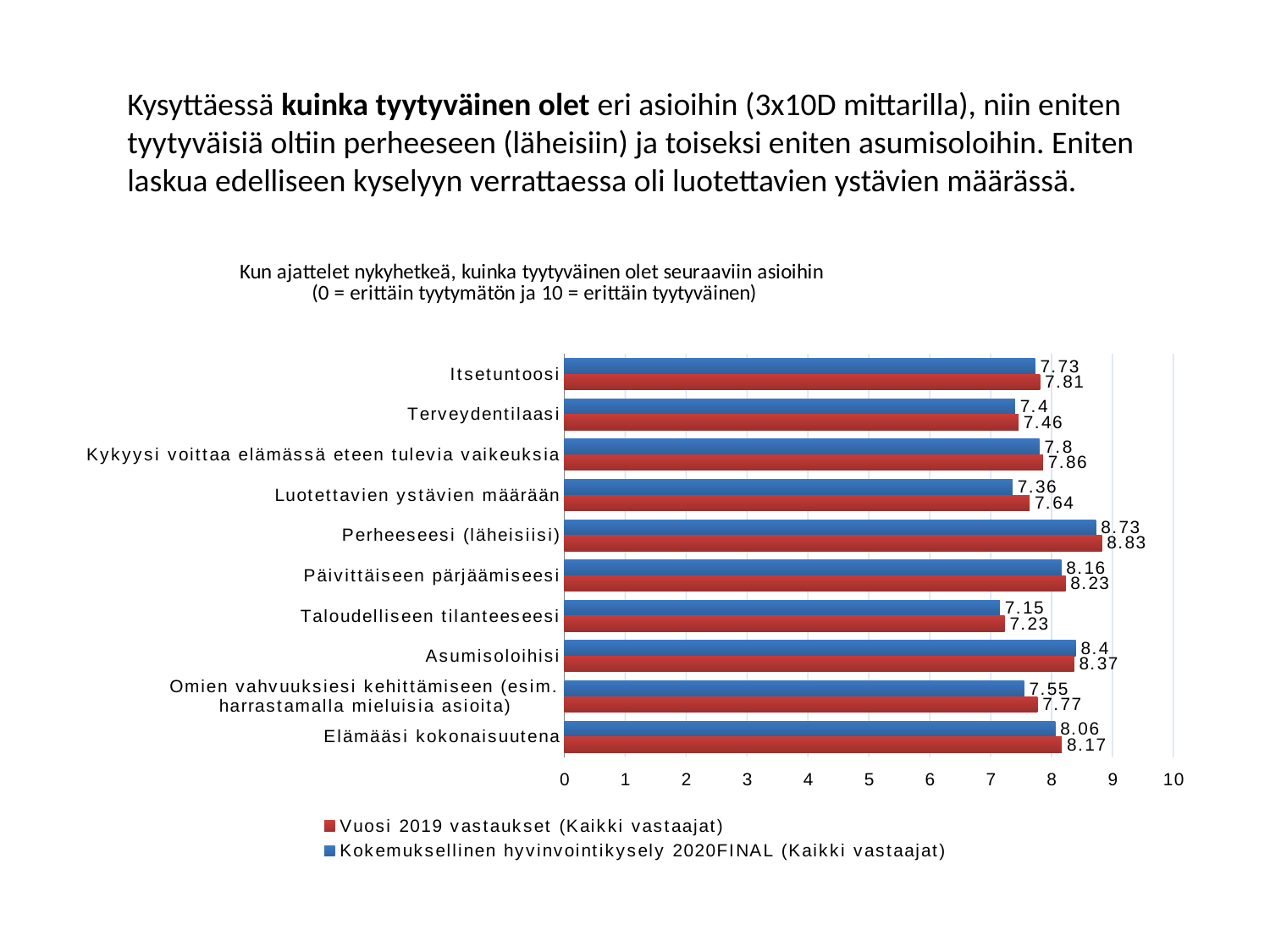
What is the 2020 (Kokemuksellinen hyvinvointikysely 2020FINAL) value for Perheeseesi (läheisiisi)? 8.73 Is the 2020 value for Elämääsi kokonaisuutena greater or less than 8? greater How many categories are shown on the chart? 10 Which category has the lowest 2020 (Kokemuksellinen hyvinvointikysely 2020FINAL) value? Taloudelliseen tilanteeseesi What is the difference between the Vuosi 2019 and 2020 values for Luotettavien ystävien määrään? 0.28 Which colour represents the Vuosi 2019 vastaukset series? Red Which category has the highest Vuosi 2019 value? Perheeseesi (läheisiisi) What is the Vuosi 2019 value for Luotettavien ystävien määrään? 7.64 For Asumisoloihisi, which series has the larger value: Vuosi 2019 or 2020FINAL? Kokemuksellinen hyvinvointikysely 2020FINAL (Kaikki vastaajat) How many series does the legend list? 2 What is the 2020 value for Taloudelliseen tilanteeseesi? 7.15 What kind of chart is shown on the slide? Bar chart